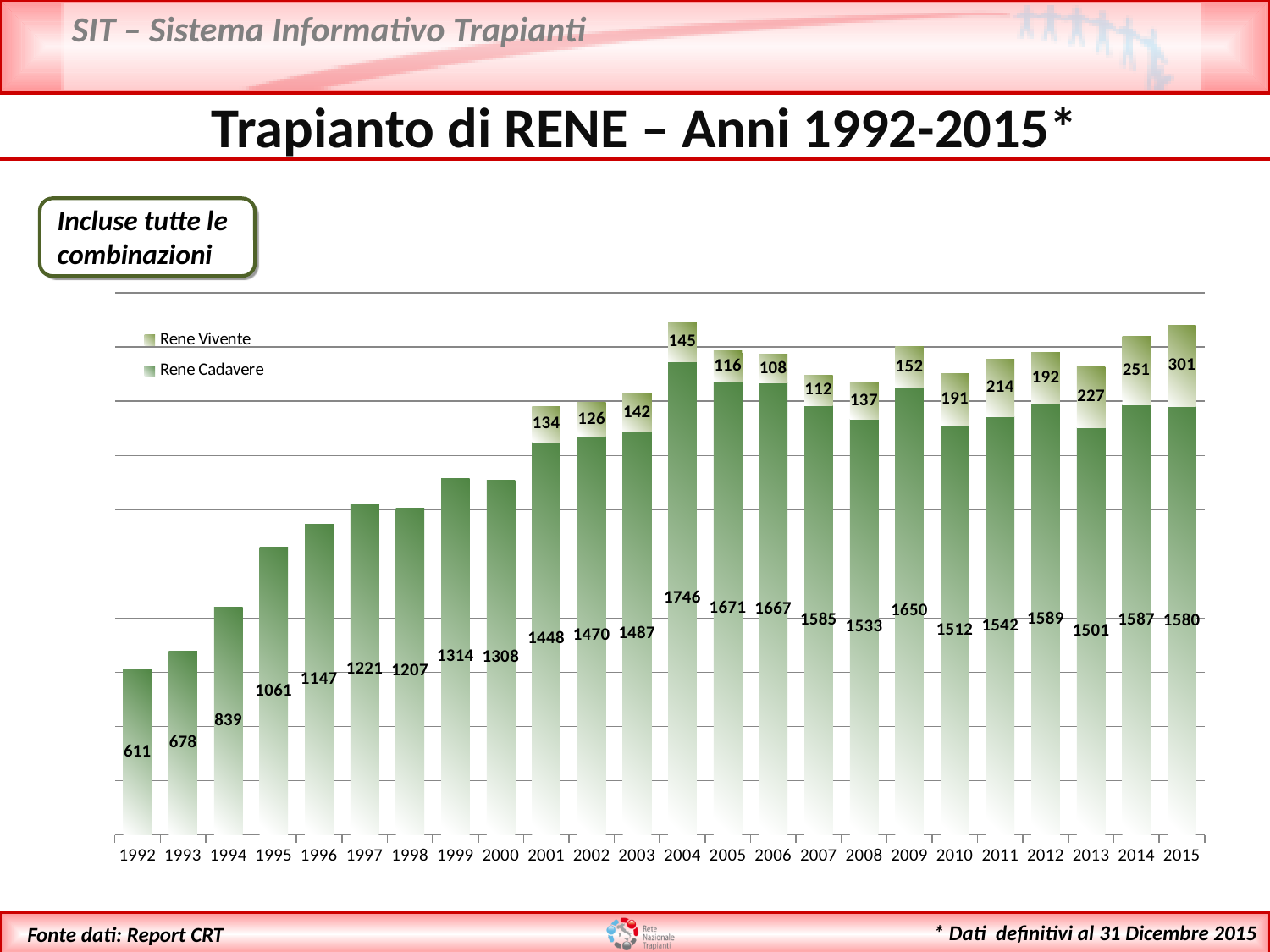
How many series does the legend list? 2 What is the Rene Cadavere value for 1992? 611 What is the Rene Cadavere value for 2004? 1746 Which is larger, the Rene Vivente value for 2013 or for 2012? 2013 How many years are shown on the x axis? 24 Which year has the highest Rene Cadavere value? 2004 What is the total of the stacked bar for 2015? 1881 Which year has the highest Rene Vivente value? 2015 What is the difference between the Rene Cadavere values for 2015 and 1992? 969 Which year has the lowest Rene Cadavere value? 1992 What is the Rene Vivente value for 2015? 301 What type of chart is shown on the slide? stacked bar chart